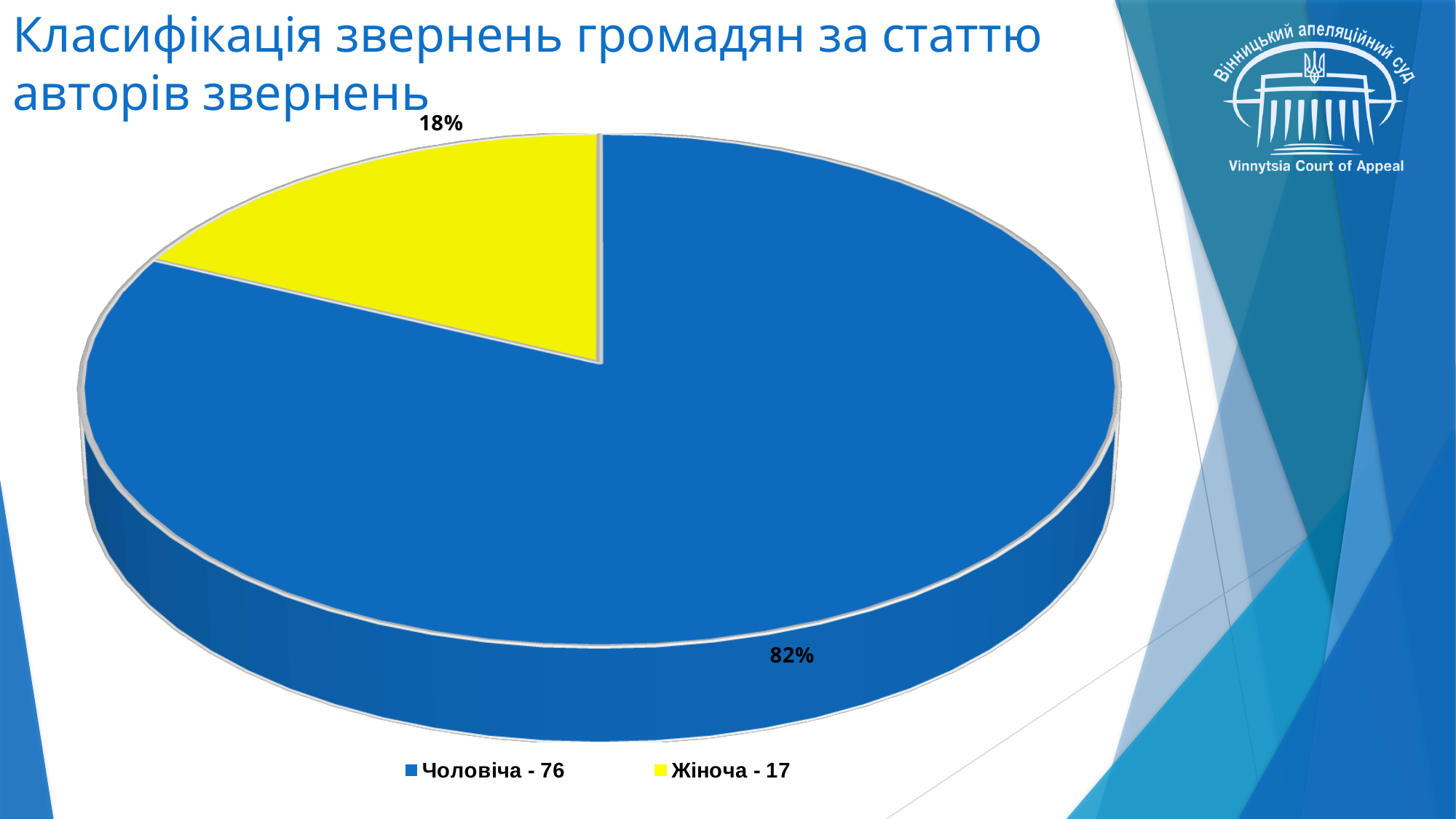
What kind of chart is shown on the slide? pie chart How many entries does the legend list? 2 What is the difference in percentage points between the "Чоловіча - 76" and "Жіноча - 17" slices? 64% What percentage share does the "Жіноча - 17" slice have? 18% What colour is the "Жіноча - 17" slice? yellow What percentage share does the "Чоловіча - 76" slice have? 82% How many slices does the pie chart have? 2 Which slice is the largest? Чоловіча - 76 What is the title of the slide? Класифікація звернень громадян за статтю авторів звернень Is the share of the "Чоловіча - 76" slice greater or less than 50%? greater Which is larger, the "Чоловіча - 76" slice or the "Жіноча - 17" slice? Чоловіча - 76 Which slice is the smallest? Жіноча - 17